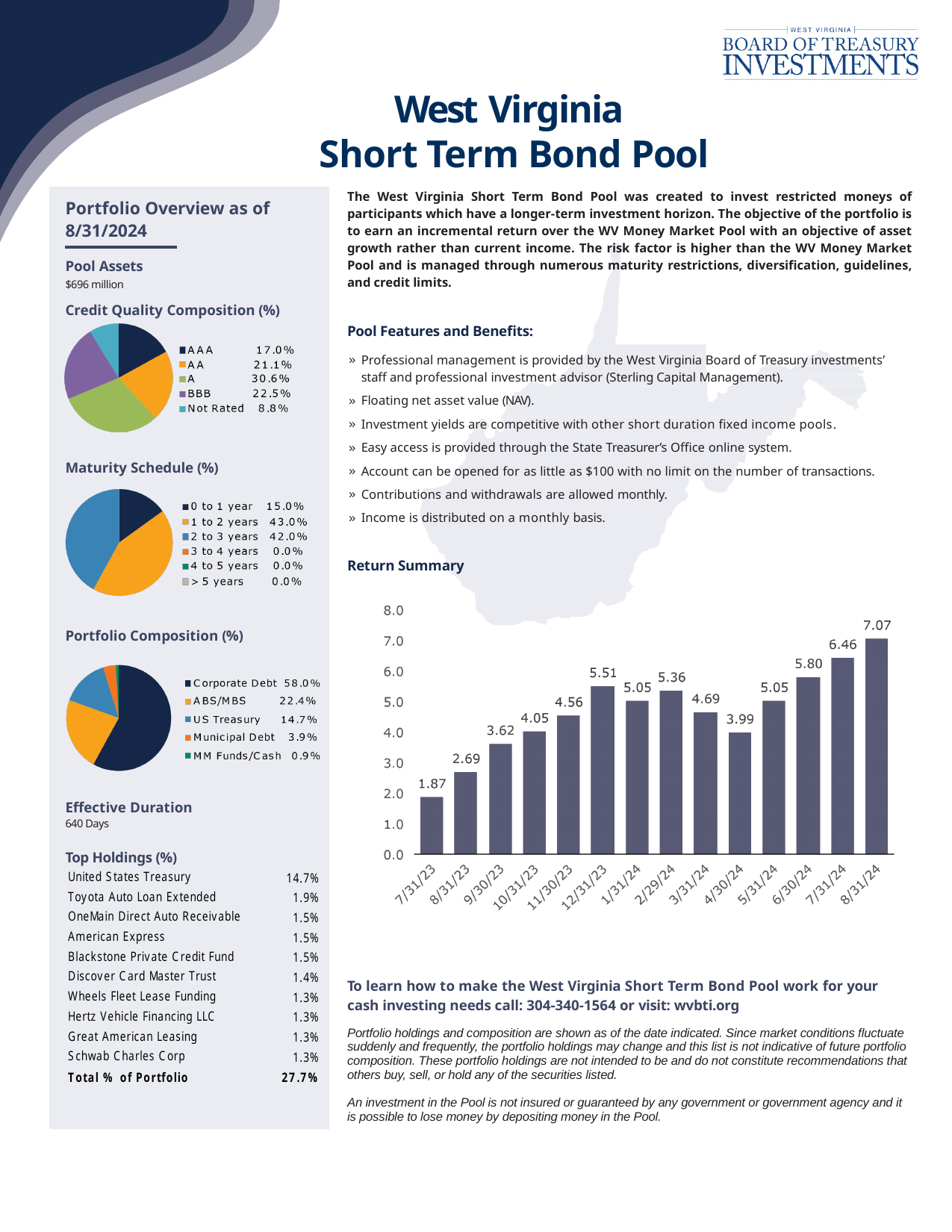
In the Return Summary chart, which date has the lowest value? 7/31/23 How many categories does the legend of the Portfolio Composition pie chart list? 5 What kind of chart is the Return Summary chart? bar chart How many bars are plotted in the Return Summary chart? 14 In the Return Summary chart, what is the value for 8/31/24? 7.07 In the Credit Quality Composition pie chart, what share does the A category have? 30.6% In the Return Summary chart, do the values rise or fall from 3/31/24 to 4/30/24? fall In the Credit Quality Composition pie chart, which category has the smallest share? Not Rated In the Maturity Schedule pie chart, what is the value for 1 to 2 years? 43.0% In the Return Summary chart, what is the difference between the values for 8/31/24 and 7/31/24? 0.61 In the Portfolio Composition pie chart, which category has the largest share? Corporate Debt In the Return Summary chart, which is larger, the value for 12/31/23 or the value for 2/29/24? 12/31/23